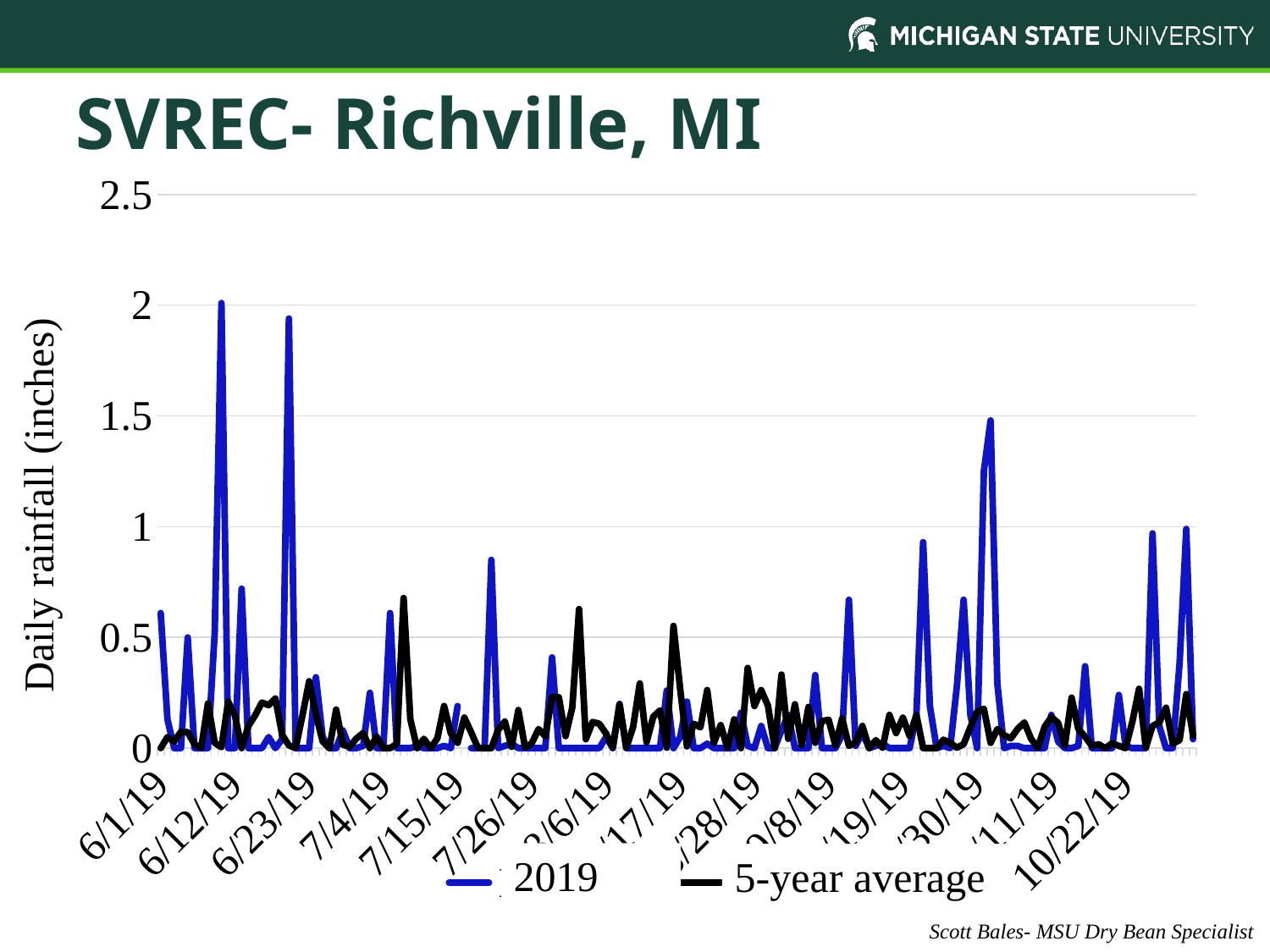
Which series reaches the highest daily rainfall value on the chart, 2019 or 5-year average? 2019 What is the title of the chart? SVREC- Richville, MI Is the 2019 peak near 7/26/19 greater or less than 1 inch? less Is the 2019 peak near 7/26/19 greater or less than 0.5 inches? greater Is the 2019 peak near 6/23/19 greater or less than 1.5 inches? greater How many series does the legend list? 2 What is the label of the vertical axis? Daily rainfall (inches) What kind of chart is shown on the slide? Line chart What is the highest value shown on the vertical axis? 2.5